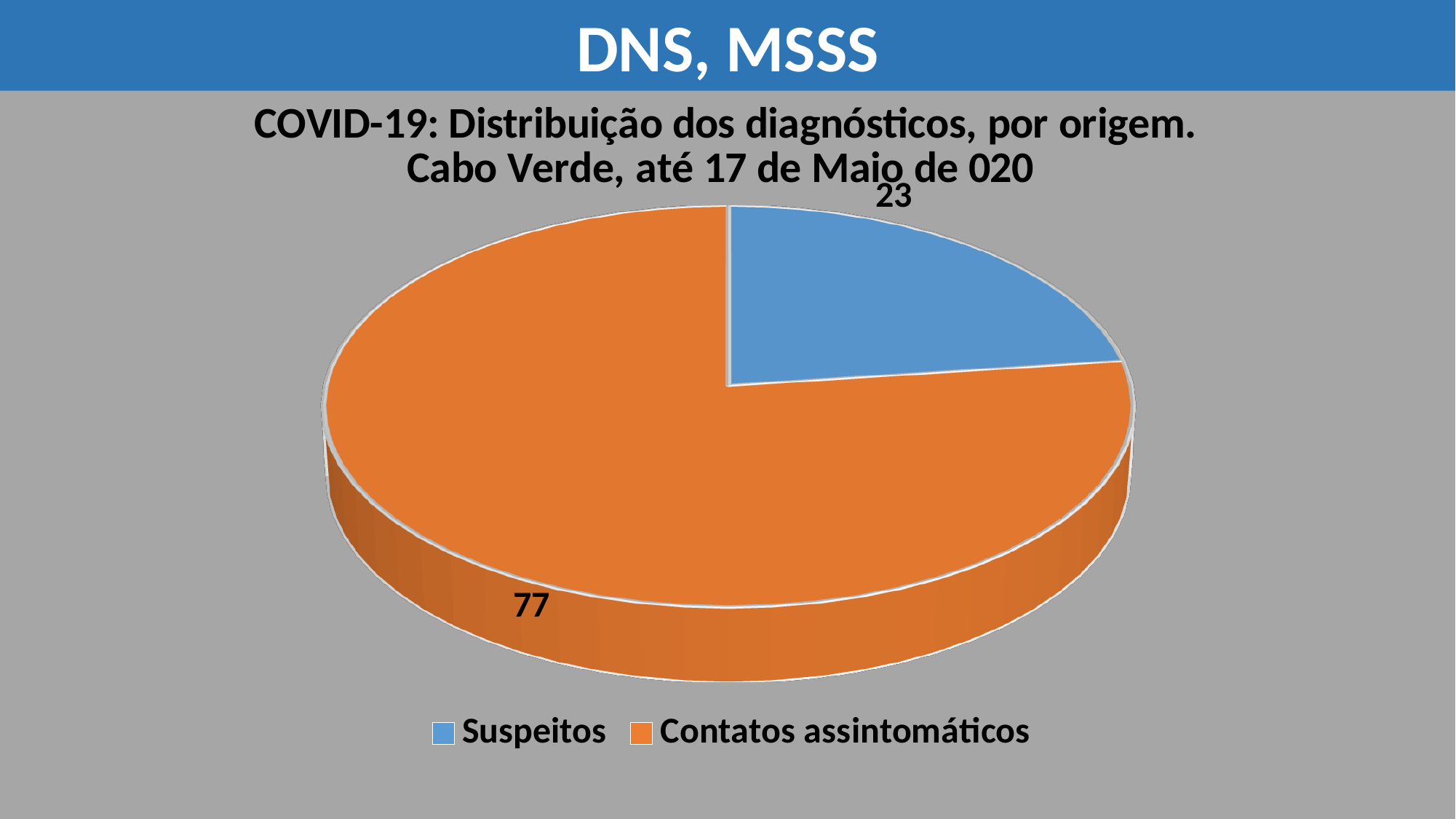
What share of the pie does Suspeitos represent? 23% Which category has the smallest slice of the pie? Suspeitos What is the value for Contatos assintomáticos? 77 What kind of chart is shown on the slide? Pie chart How many categories does the pie chart show? 2 Which is larger, the value for Suspeitos or the value for Contatos assintomáticos? Contatos assintomáticos What is the title of the chart? COVID-19: Distribuição dos diagnósticos, por origem. Cabo Verde, até 17 de Maio de 020 What colour is the Contatos assintomáticos slice? Orange Which category has the largest slice of the pie? Contatos assintomáticos What is the value for Suspeitos? 23 What is the difference between the values for Contatos assintomáticos and Suspeitos? 54 What is the total of the two values shown in the pie chart? 100